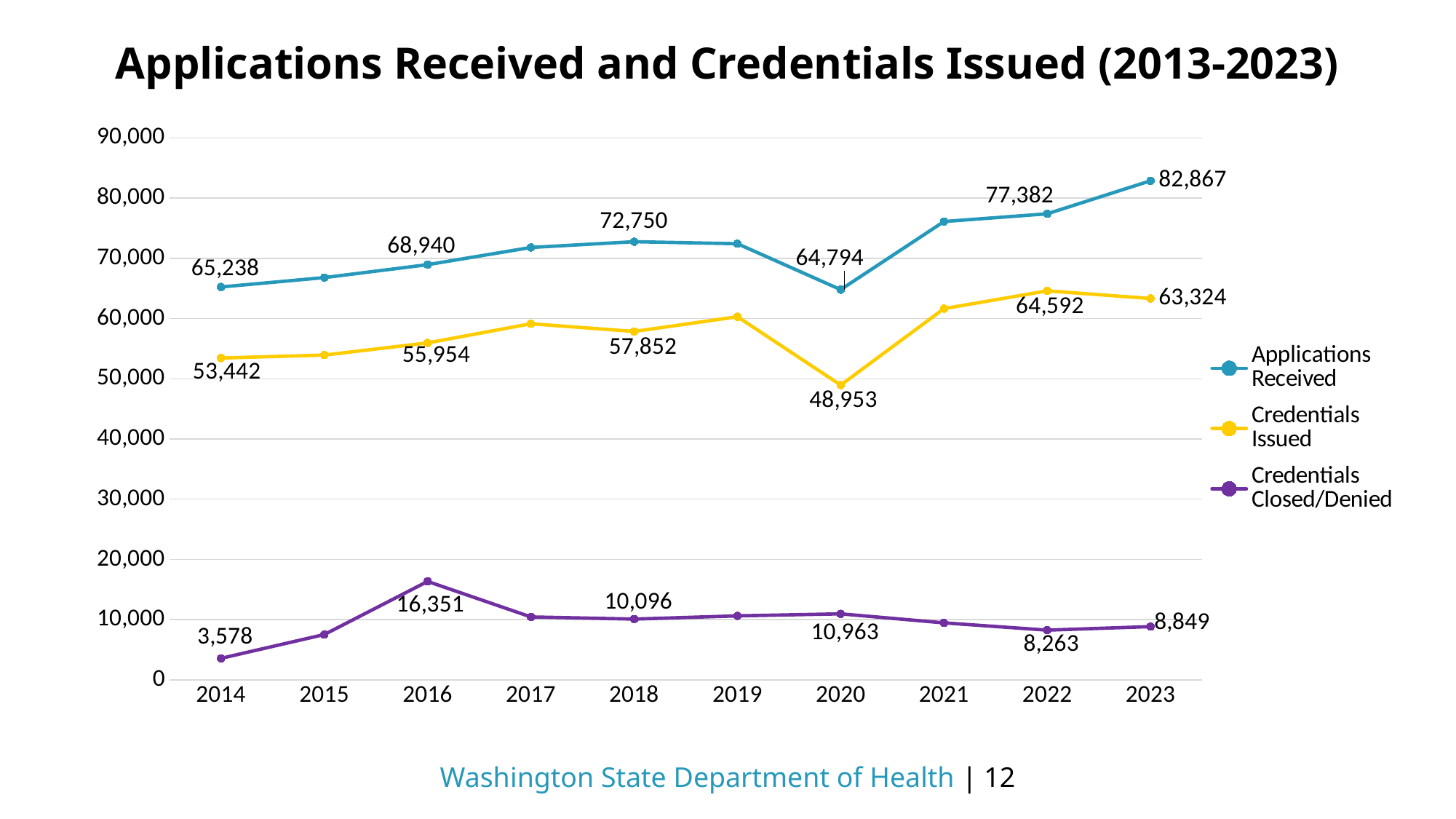
How many years are plotted on the x axis? 10 In which year is Applications Received highest? 2023 What is the value for Credentials Issued in 2020? 48,953 What is the value for Applications Received in 2023? 82,867 Is the value for Applications Received in 2017 greater or less than 70,000? greater How many series does the legend list? 3 What is the value for Credentials Closed/Denied in 2016? 16,351 Which year has the larger value for Credentials Issued, 2022 or 2023? 2022 What is the difference between Applications Received in 2023 and in 2022? 5,485 In which year is Credentials Closed/Denied lowest? 2014 In which year is Credentials Issued lowest? 2020 In 2014, what is the difference between Applications Received and Credentials Issued? 11,796